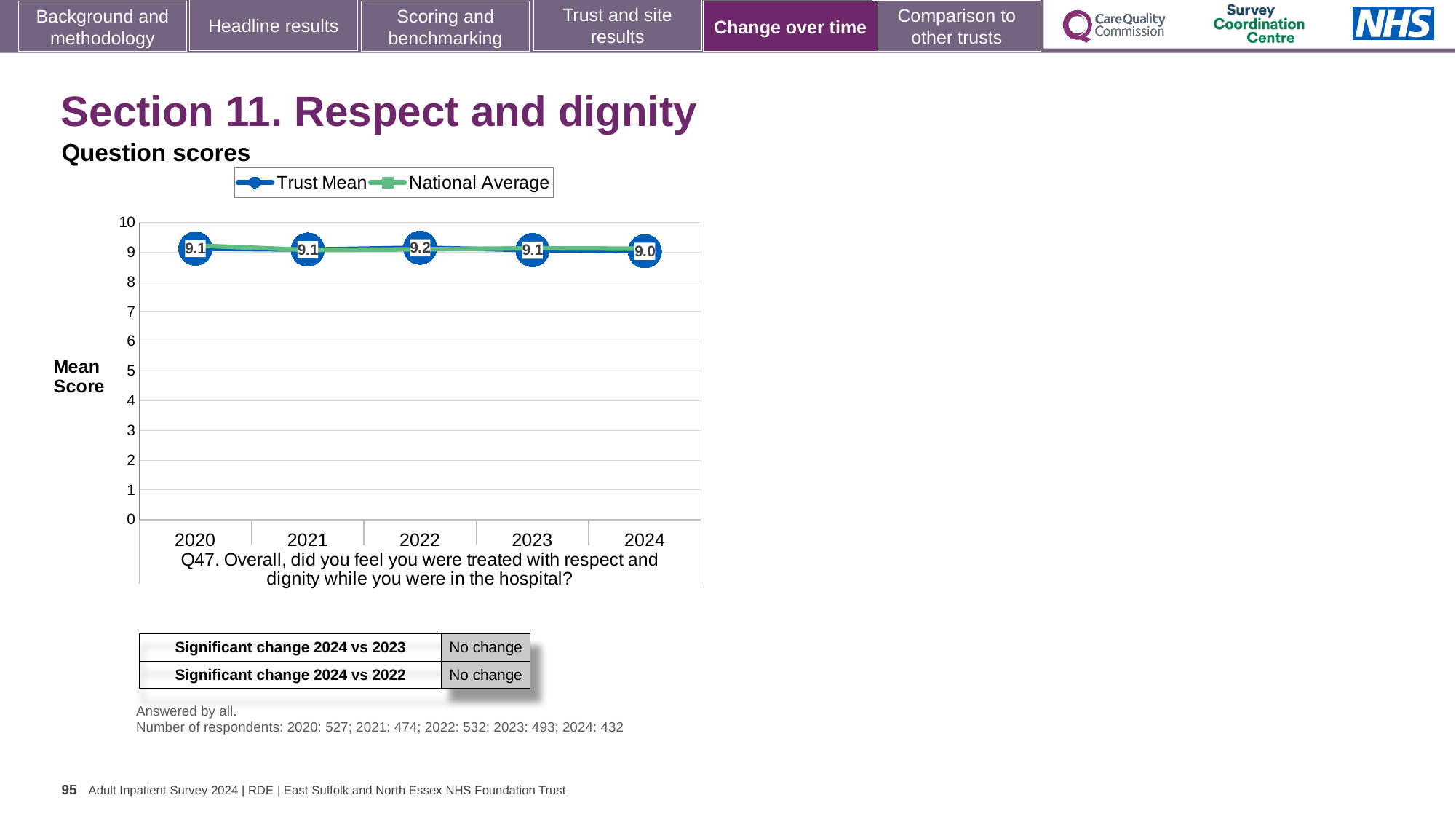
What is the label of the y axis of the chart? Mean Score How many years are shown on the x axis of the chart? 5 What is the difference between the Trust Mean scores for 2022 and 2024? 0.2 What is the Trust Mean score for 2020? 9.1 What is the Trust Mean score for 2022? 9.2 In which year is the Trust Mean score lowest? 2024 Which is larger, the Trust Mean score for 2022 or for 2023? 2022 In which year is the Trust Mean score highest? 2022 How many series does the chart legend list? 2 What kind of chart is shown on the slide? Line chart Is the Trust Mean score for 2021 greater or less than 8? greater What is the Trust Mean score for 2024? 9.0